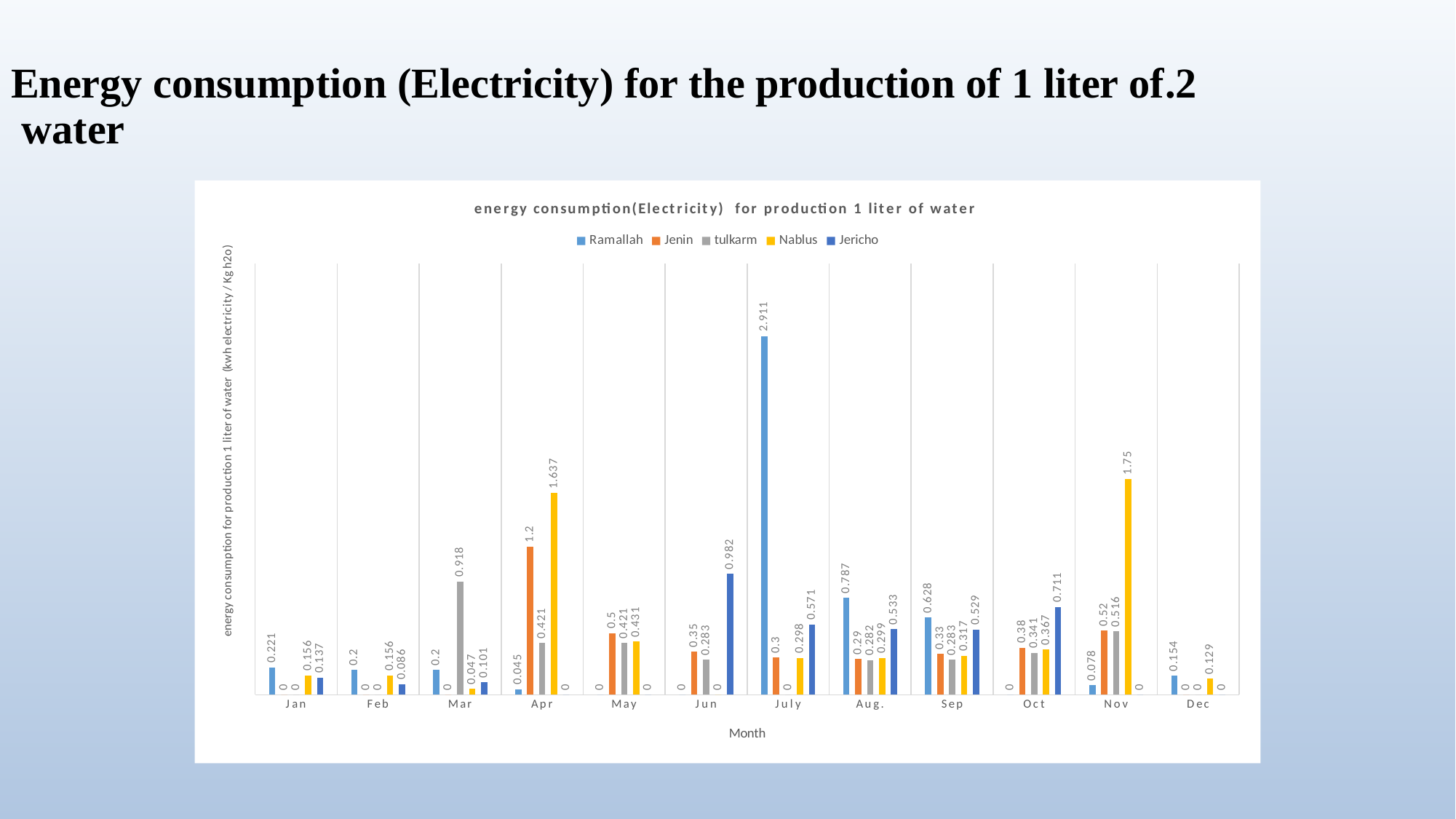
Which is larger in Oct, the value for Jericho or the value for Jenin? Jericho How many months are shown on the x axis? 12 What is the difference between the Nablus and Jenin values in Apr? 0.437 What is the value for tulkarm in Mar? 0.918 What is the value for Jericho in Jun? 0.982 How many series does the legend list? 5 What is the label of the x axis? Month What is the value for Nablus in Nov? 1.75 Which month has the highest value for Nablus? Nov What kind of chart is shown on the slide? bar chart Which city has the highest value in Apr? Nablus What is the value for Ramallah in July? 2.911